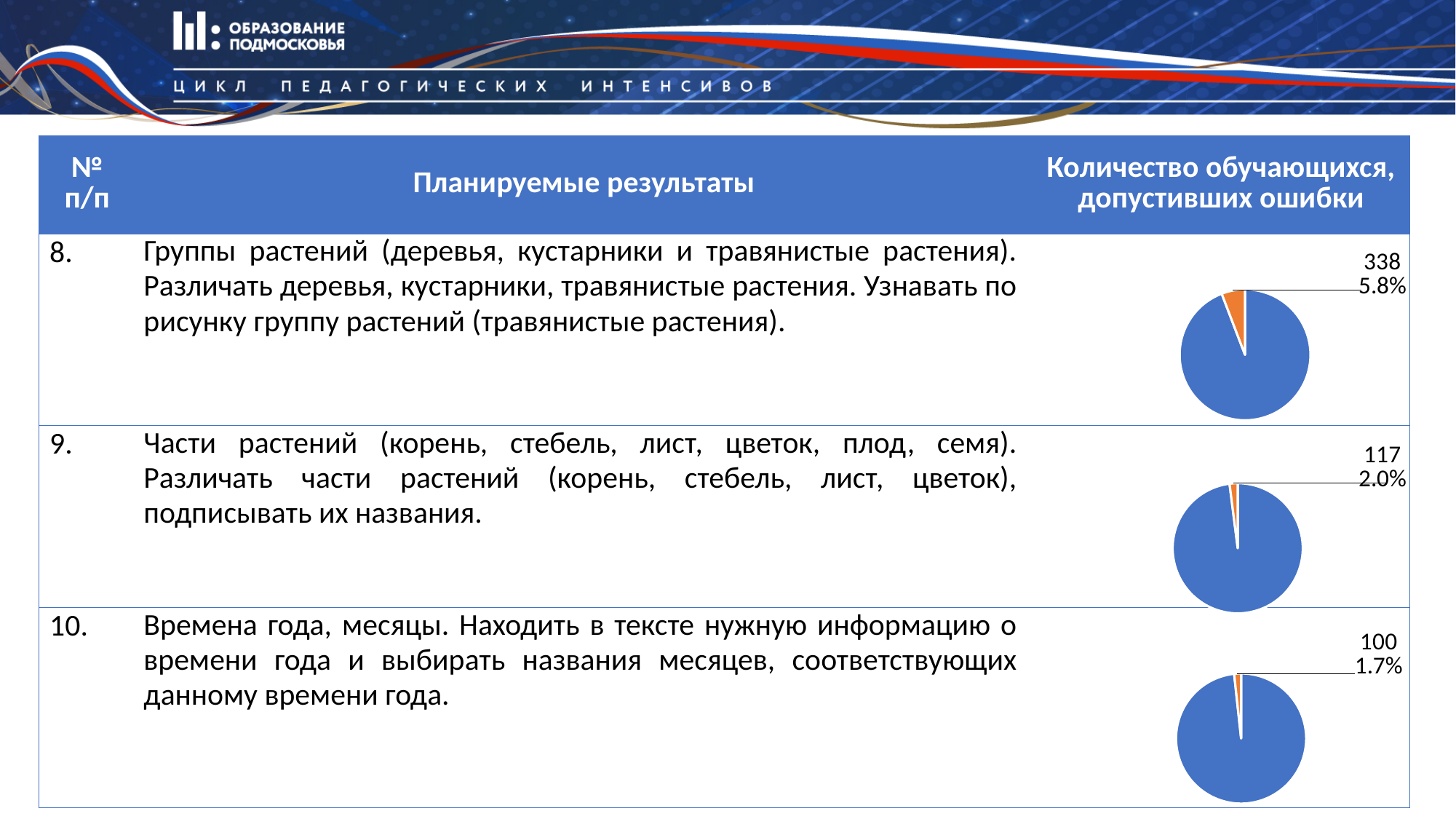
In the pie chart for row 9 (Части растений), how many students made errors according to the data label? 117 Which row's pie chart shows the smallest number of students who made errors: row 8, row 9 or row 10? Row 10 What colour is the slice representing students who made errors in the pie charts? Orange In the pie chart for row 10 (Времена года, месяцы), how many students made errors according to the data label? 100 In the pie chart for row 9 (Части растений), what percentage share does the orange slice have? 2.0% In the pie chart for row 10 (Времена года, месяцы), what percentage share does the orange slice have? 1.7% Which row's pie chart shows the largest number of students who made errors: row 8, row 9 or row 10? Row 8 How many slices does the pie chart for row 8 contain? 2 In the pie chart for row 8 (Группы растений), what percentage share does the orange slice have? 5.8% In the pie chart for row 8 (Группы растений), how many students made errors according to the data label? 338 What type of chart is shown in each row of the table? Pie chart What is the difference between the number of students who made errors in row 8 and in row 9? 221